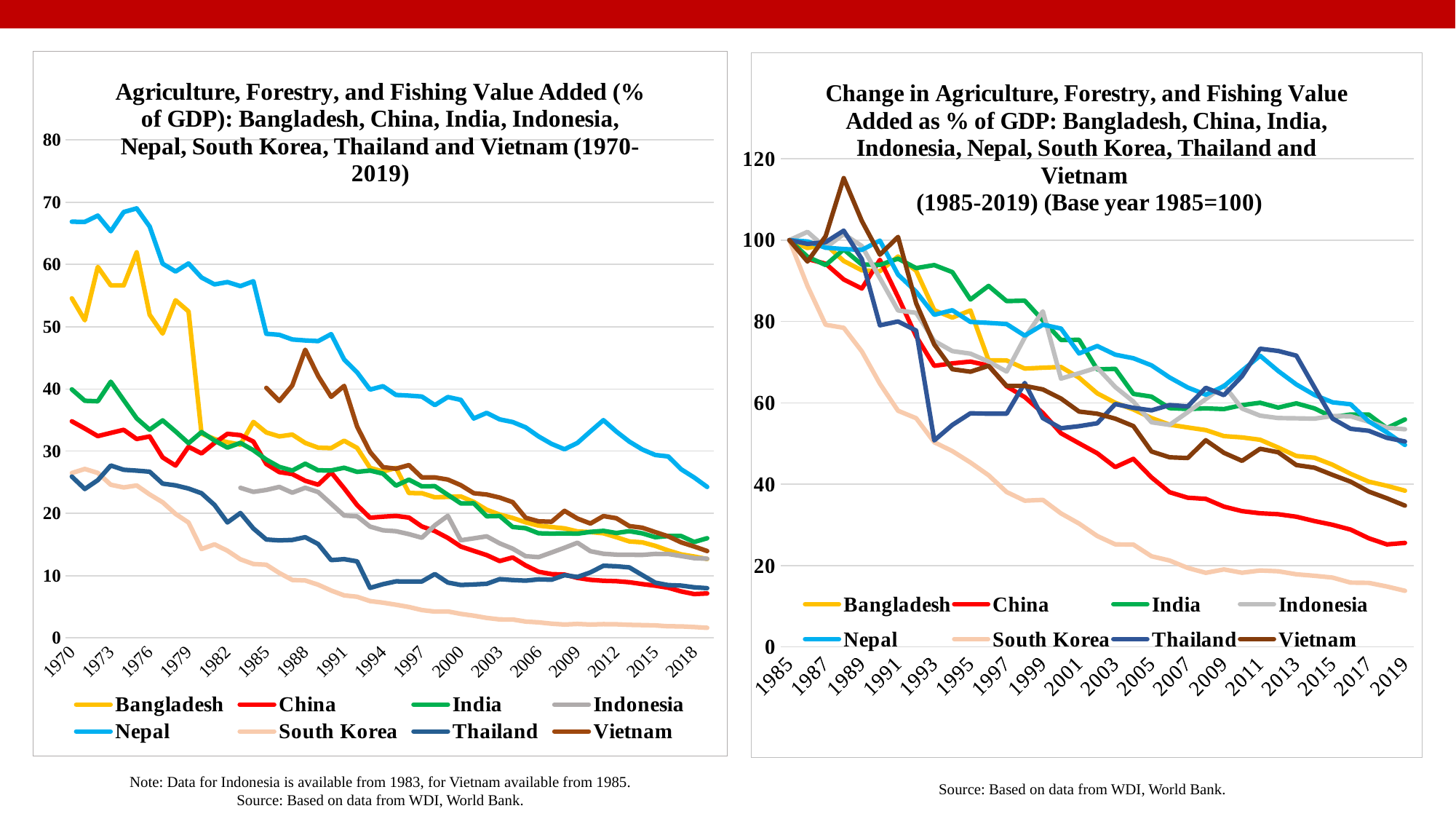
In the right chart, is the value for Vietnam in 1988 greater or less than 110? greater What kind of chart is the left chart, 'Agriculture, Forestry, and Fishing Value Added (% of GDP)'? line chart In the right chart, which is larger in 2019, the value for India or the value for China? India How many series does the legend of the right chart, 'Change in Agriculture, Forestry, and Fishing Value Added as % of GDP', list? 8 In the left chart, is the value for Nepal in 2019 greater or less than 20? greater What base year is stated in the title of the right chart? 1985 In the left chart, is the value for Bangladesh in 1970 greater or less than 50? greater In the left chart, does the Nepal line generally rise or fall from 1970 to 2019? fall In the left chart, which country has the highest value in 1970? Nepal In the right chart, which country has the lowest index value in 2019? South Korea In the left chart, which country has the lowest value in 2019? South Korea